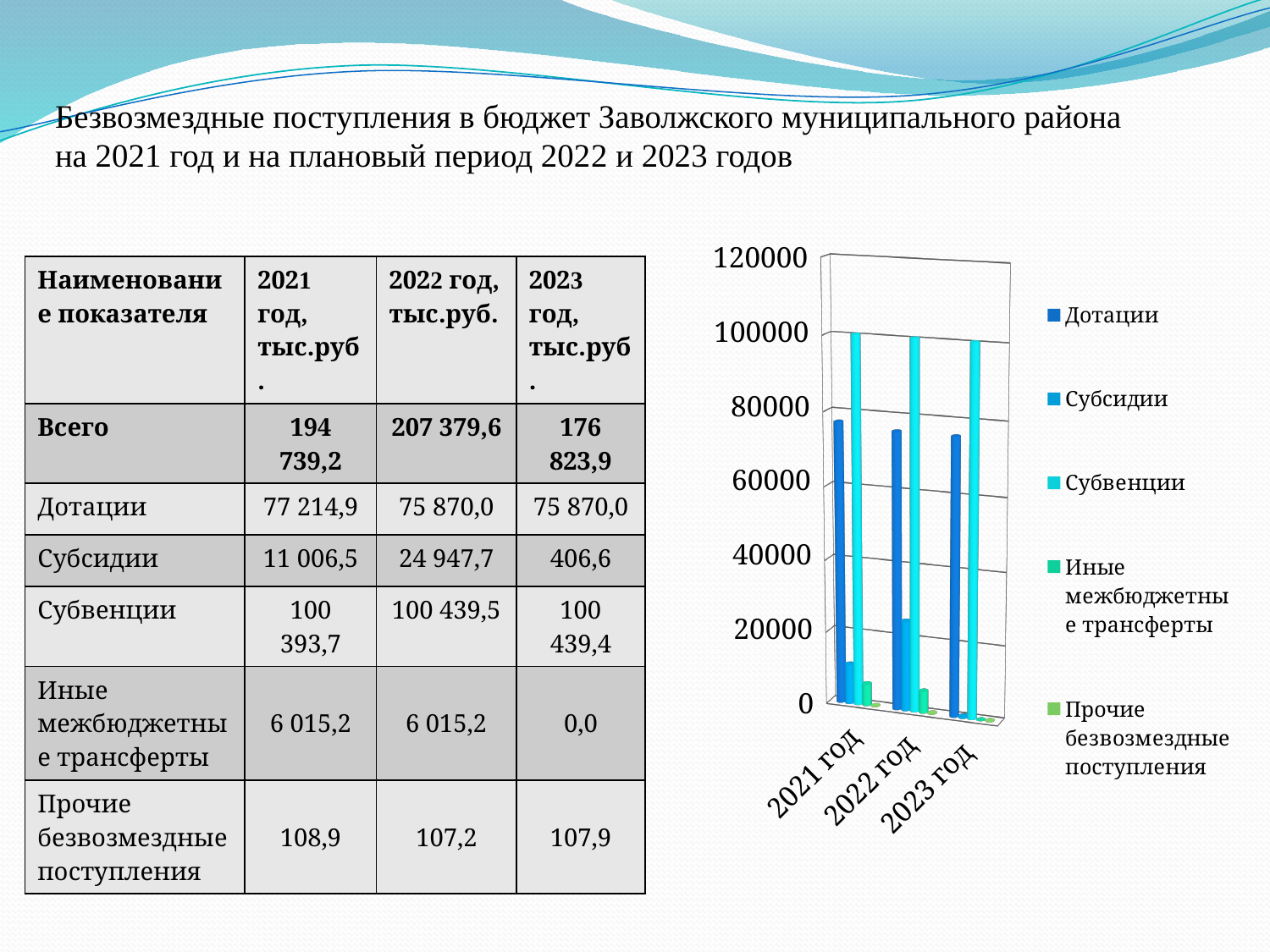
Is the value for Дотации in 2023 год greater or less than 60000? greater According to the table, what is the value of Дотации for 2021 год (тыс.руб.)? 77 214,9 How many series does the chart legend list? 5 Is the value for Субвенции in 2021 год greater or less than 80000? greater Is the value for Субсидии in 2021 год greater or less than 20000? less According to the table, what is the difference between the Субсидии values for 2022 год and 2021 год (тыс.руб.)? 13 941,2 Which is larger, the Субсидии value for 2021 год or for 2022 год? 2022 год How many year categories are shown on the chart's x axis? 3 Do the Субсидии values rise or fall from 2022 год to 2023 год? fall Which series has the tallest bar for 2021 год? Субвенции What kind of chart is shown on the slide? bar chart